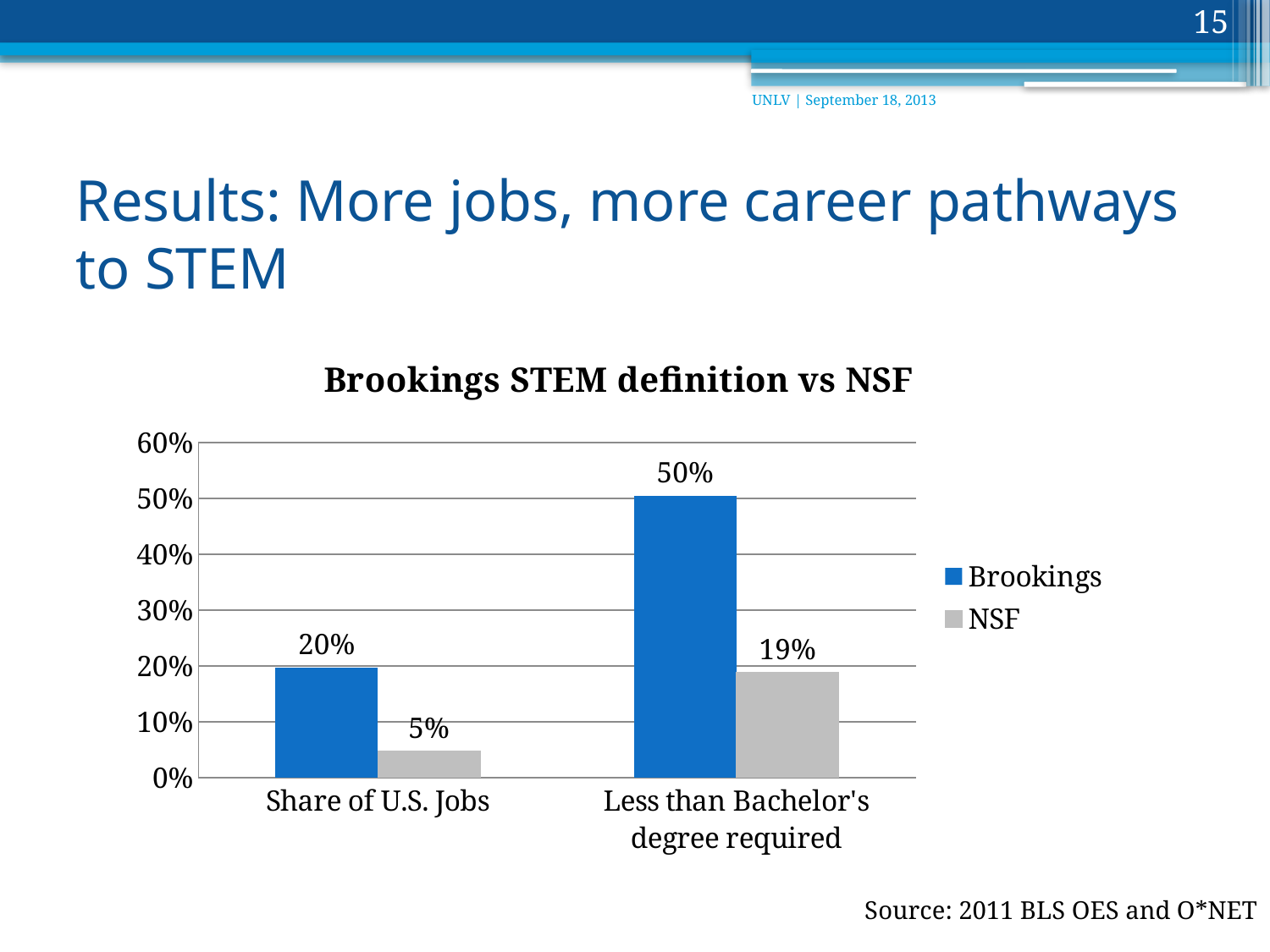
How many categories are shown on the x axis? 2 Which category has the highest Brookings value? Less than Bachelor's degree required What is the Brookings value for Less than Bachelor's degree required? 50% What kind of chart is shown on the slide? Bar chart What is the difference between the Brookings and NSF values for Less than Bachelor's degree required? 31% What is the NSF value for Share of U.S. Jobs? 5% What is the NSF value for Less than Bachelor's degree required? 19% What is the Brookings value for Share of U.S. Jobs? 20% What is the title of the chart? Brookings STEM definition vs NSF Which category has the lowest NSF value? Share of U.S. Jobs Which is larger for Share of U.S. Jobs, the Brookings value or the NSF value? Brookings How many series does the legend list? 2